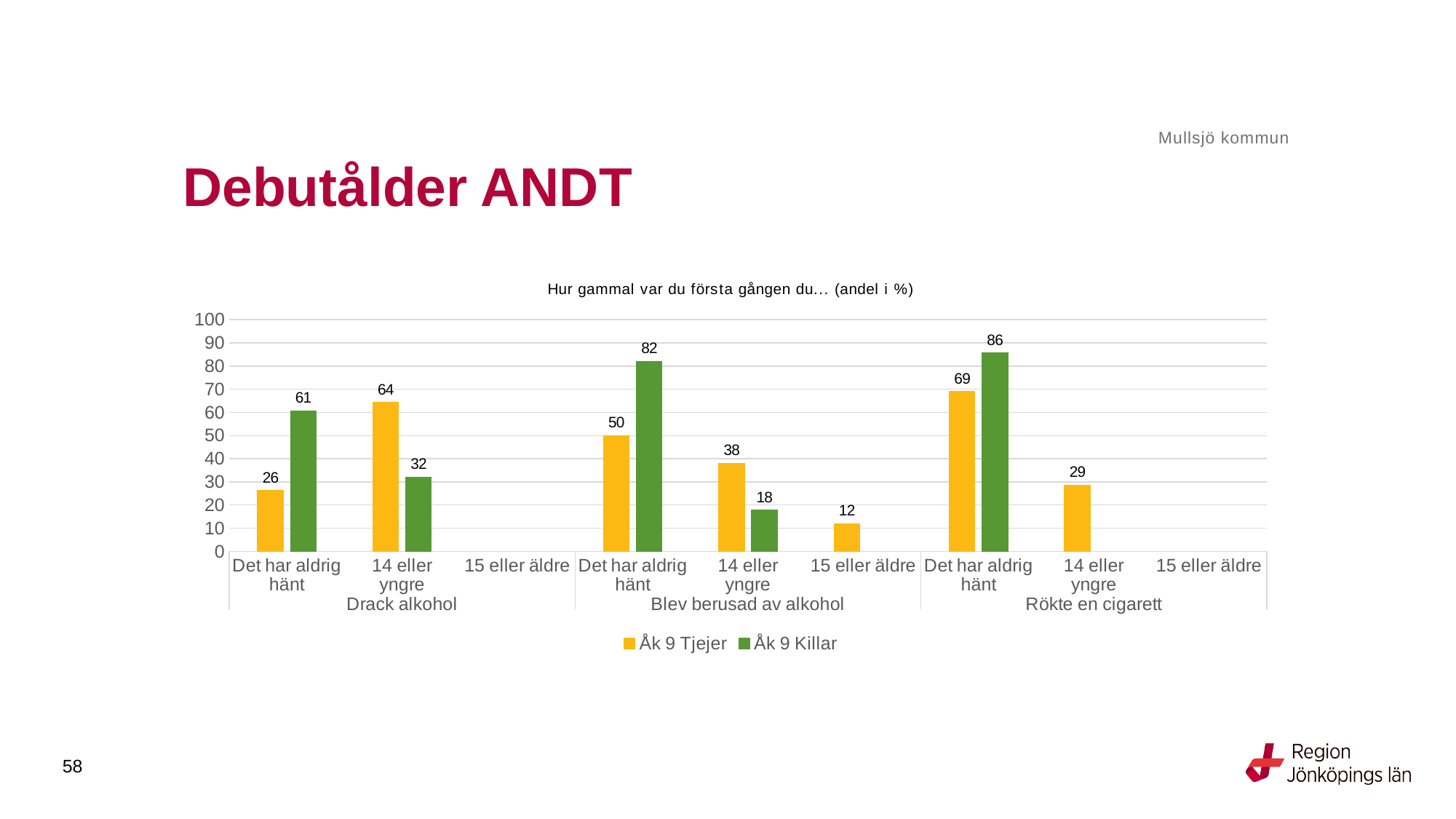
For '14 eller yngre' under 'Blev berusad av alkohol', which series has the larger value, Åk 9 Tjejer or Åk 9 Killar? Åk 9 Tjejer How many series does the legend list? 2 What is the value for Åk 9 Tjejer for '15 eller äldre' under 'Blev berusad av alkohol'? 12 Which bar has the lowest labelled value in the chart? Åk 9 Tjejer, 15 eller äldre, Blev berusad av alkohol (12) What is the difference between Åk 9 Killar and Åk 9 Tjejer for 'Det har aldrig hänt' under 'Blev berusad av alkohol'? 32 Which bar has the highest value in the chart? Åk 9 Killar, Det har aldrig hänt, Rökte en cigarett (86) Is the value for Åk 9 Tjejer for 'Det har aldrig hänt' under 'Rökte en cigarett' greater or less than 60? greater What is the value for Åk 9 Tjejer for '14 eller yngre' under 'Drack alkohol'? 64 What is the value for Åk 9 Killar for 'Det har aldrig hänt' under 'Rökte en cigarett'? 86 What is the value for Åk 9 Killar for 'Det har aldrig hänt' under 'Drack alkohol'? 61 What is the title of the chart? Hur gammal var du första gången du… (andel i %) What kind of chart is shown on the slide? Bar chart